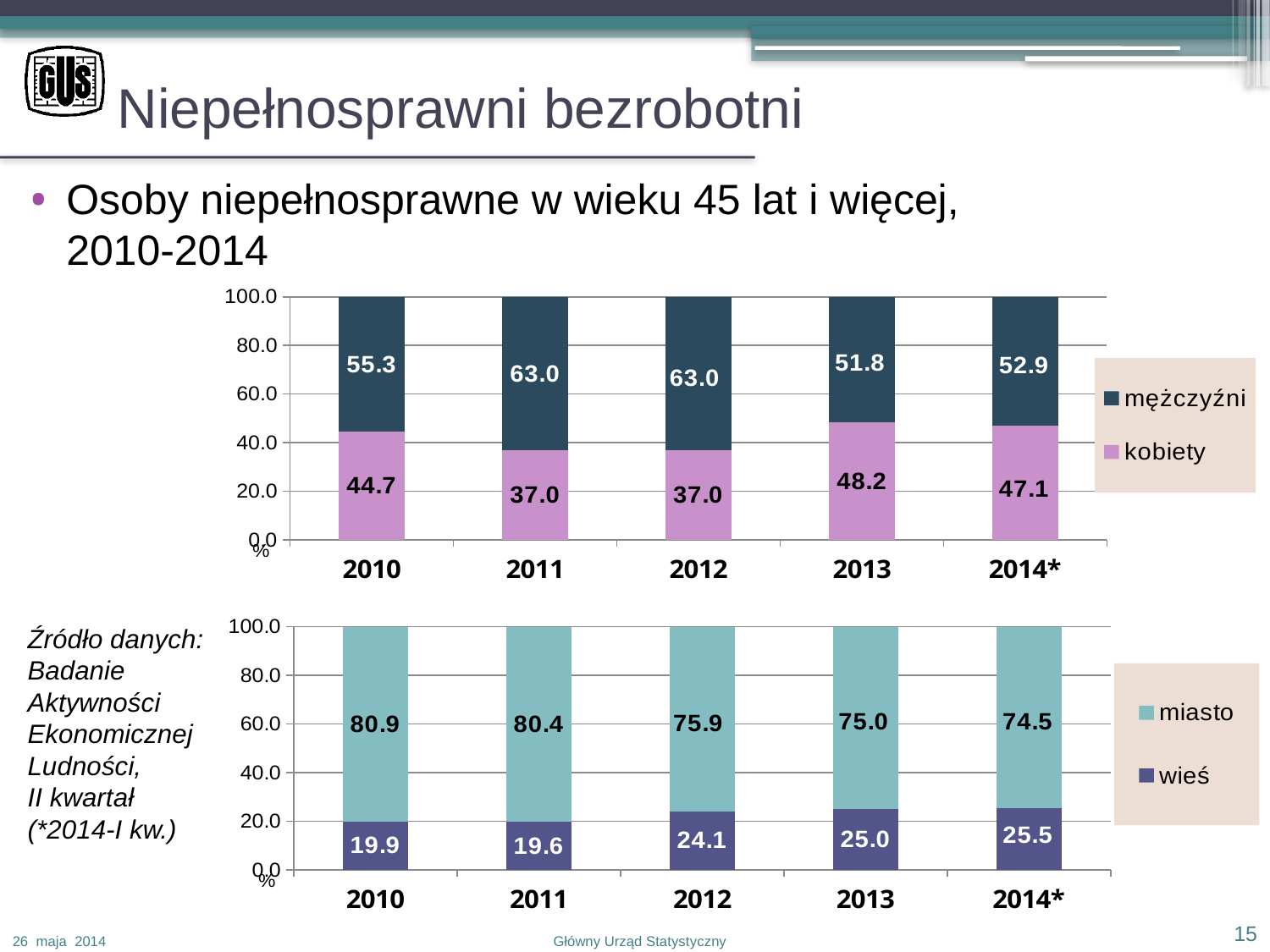
In the top chart, which is larger in 2014*: mężczyźni or kobiety? mężczyźni In the bottom chart, in which year is the miasto share highest? 2010 How many years are shown on the x axis of the top chart? 5 In the bottom chart, what is the value for miasto in 2014*? 74.5 In the bottom chart, does the wieś share rise or fall from 2011 to 2014*? rise In the bottom chart, what is the value for wieś in 2012? 24.1 In the top chart, in which year is the kobiety share lowest? 2011 and 2012 (37.0) In the bottom chart, what is the total of the stacked bar for 2013? 100.0 In the top chart, what is the difference between the mężczyźni and kobiety values in 2011? 26.0 What kind of chart is the bottom chart? stacked bar chart In the top chart, what is the value for mężczyźni in 2010? 55.3 In the top chart, what is the value for kobiety in 2013? 48.2